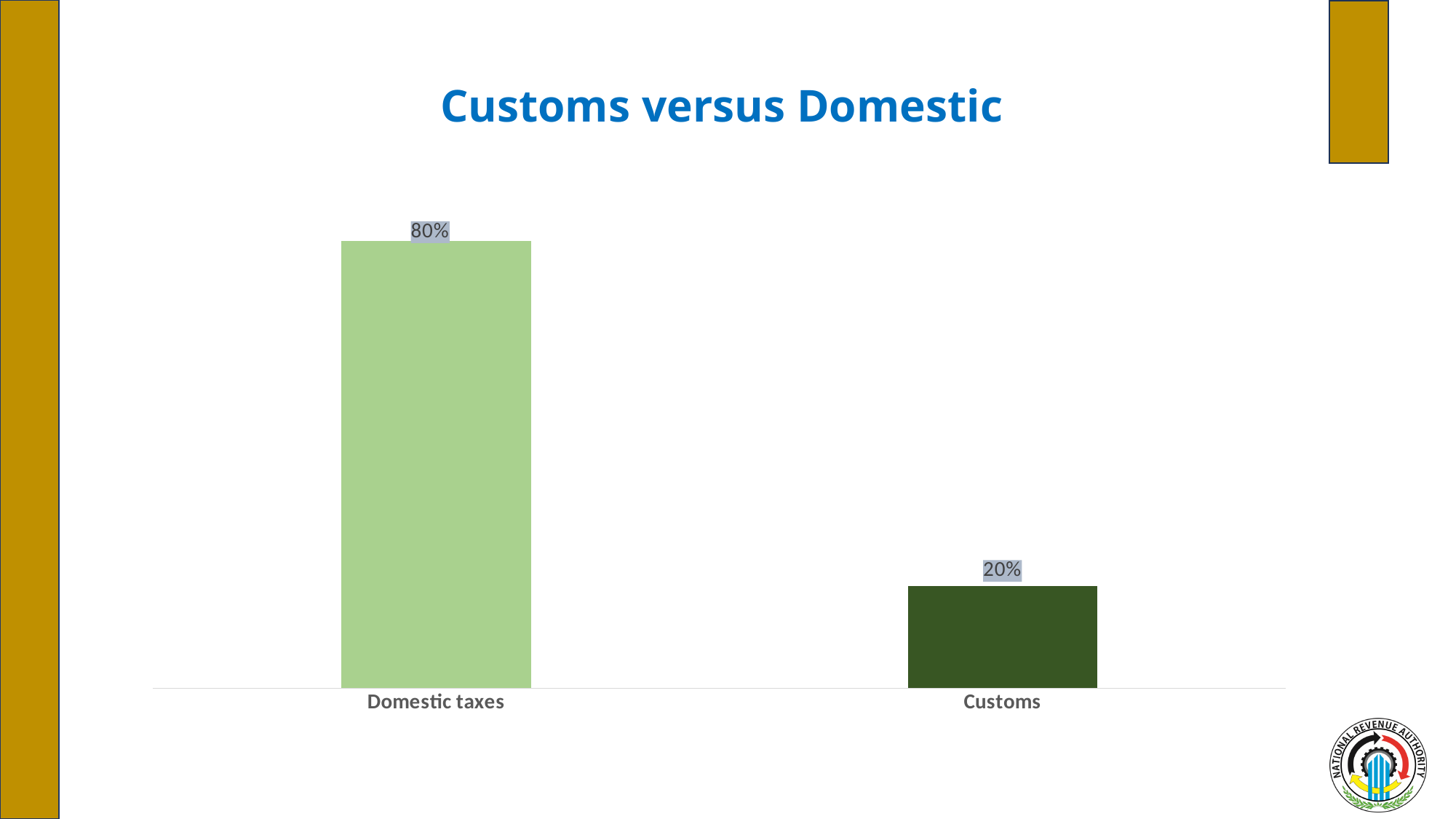
What kind of chart is shown on the slide? Bar chart What is the value for Domestic taxes? 80% What is the total of the two values shown in the chart? 100% What is the difference between the values for Domestic taxes and Customs? 60% What colour is the bar for Customs? Dark green How many categories are shown in the chart? 2 Which category has the highest value? Domestic taxes Which is larger, the value for Domestic taxes or the value for Customs? Domestic taxes Which category has the lowest value? Customs What is the title of the chart? Customs versus Domestic What is the value for Customs? 20%